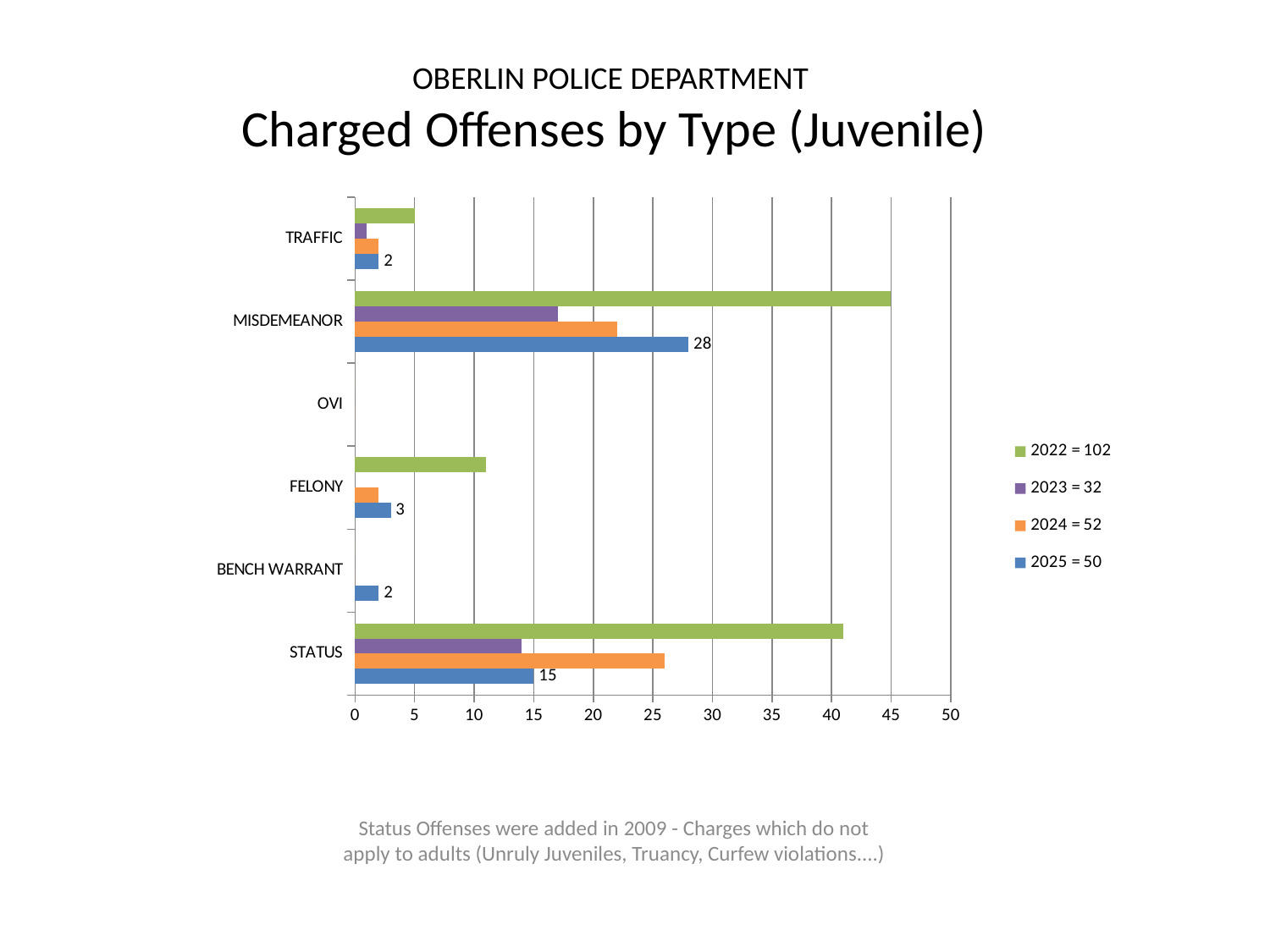
What is the 2025 value for MISDEMEANOR? 28 Which has the larger 2025 value, FELONY or TRAFFIC? FELONY Which series has the larger value for STATUS, 2022 or 2024? 2022 Is the 2022 value for MISDEMEANOR greater or less than 40? greater Which category has the highest 2025 value? MISDEMEANOR How many offense categories are shown on the chart? 6 What is the 2025 value for FELONY? 3 How many series does the legend list? 4 What is the 2025 value for STATUS? 15 Is the 2024 value for STATUS greater or less than 20? greater What kind of chart is shown on the slide? bar chart What is the difference between the 2025 values for MISDEMEANOR and STATUS? 13